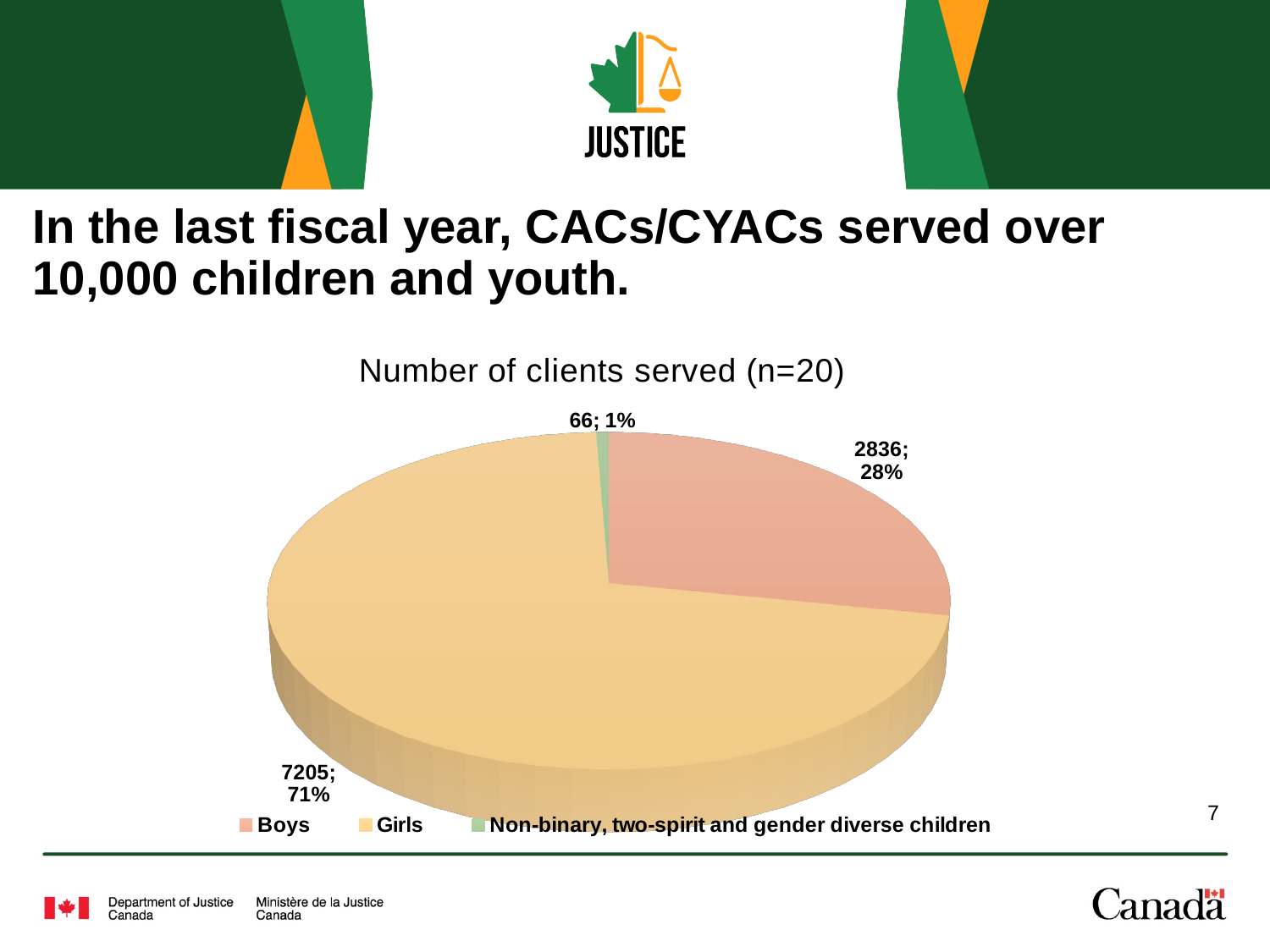
How many clients served were boys? 2836 Which category has the smallest slice of the pie? Non-binary, two-spirit and gender diverse children What share of the pie do girls represent? 71% How many clients served were girls? 7205 What is the difference between the number of girls and the number of boys served? 4369 What type of chart is shown on the slide? Pie chart What share of the pie do boys represent? 28% What share of the pie do non-binary, two-spirit and gender diverse children represent? 1% How many clients served were non-binary, two-spirit and gender diverse children? 66 How many categories does the legend list? 3 Which category has the largest slice of the pie? Girls What is the title of the chart? Number of clients served (n=20)